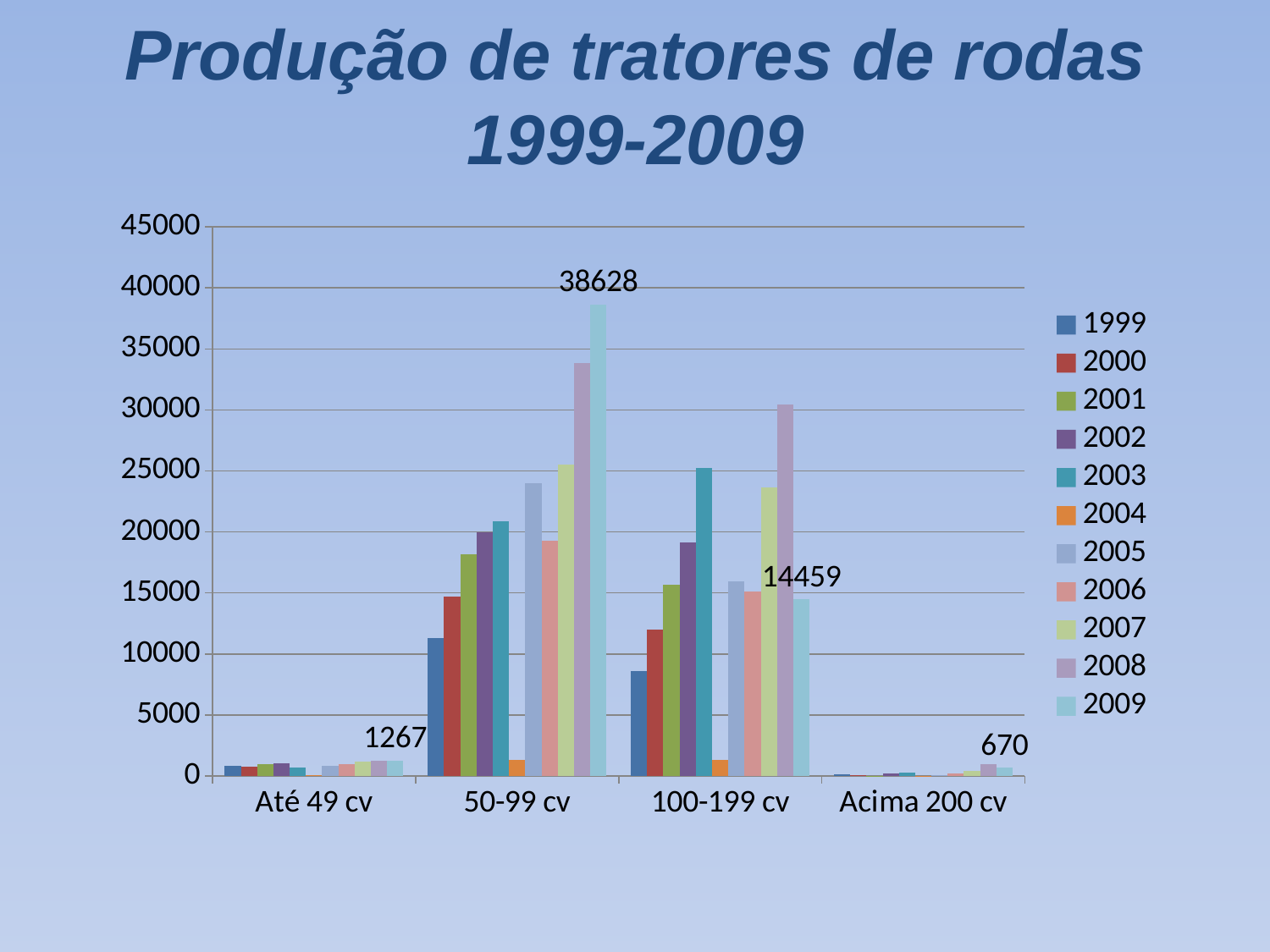
How many series does the legend list? 11 Is the 2004 value for 50-99 cv greater or less than 5000? less How many power categories are shown on the x axis? 4 What is the difference between the 2009 values for 50-99 cv and 100-199 cv? 24169 What is the 2009 value for the Até 49 cv category? 1267 What is the 2009 value for the Acima 200 cv category? 670 What is the 2009 value for the 100-199 cv category? 14459 Is the 2008 value for 50-99 cv greater or less than 30000? greater Which category has the lowest 2009 value? Acima 200 cv Which category has the highest 2009 value? 50-99 cv What is the 2009 value for the 50-99 cv category? 38628 What type of chart is shown on the slide? Bar chart